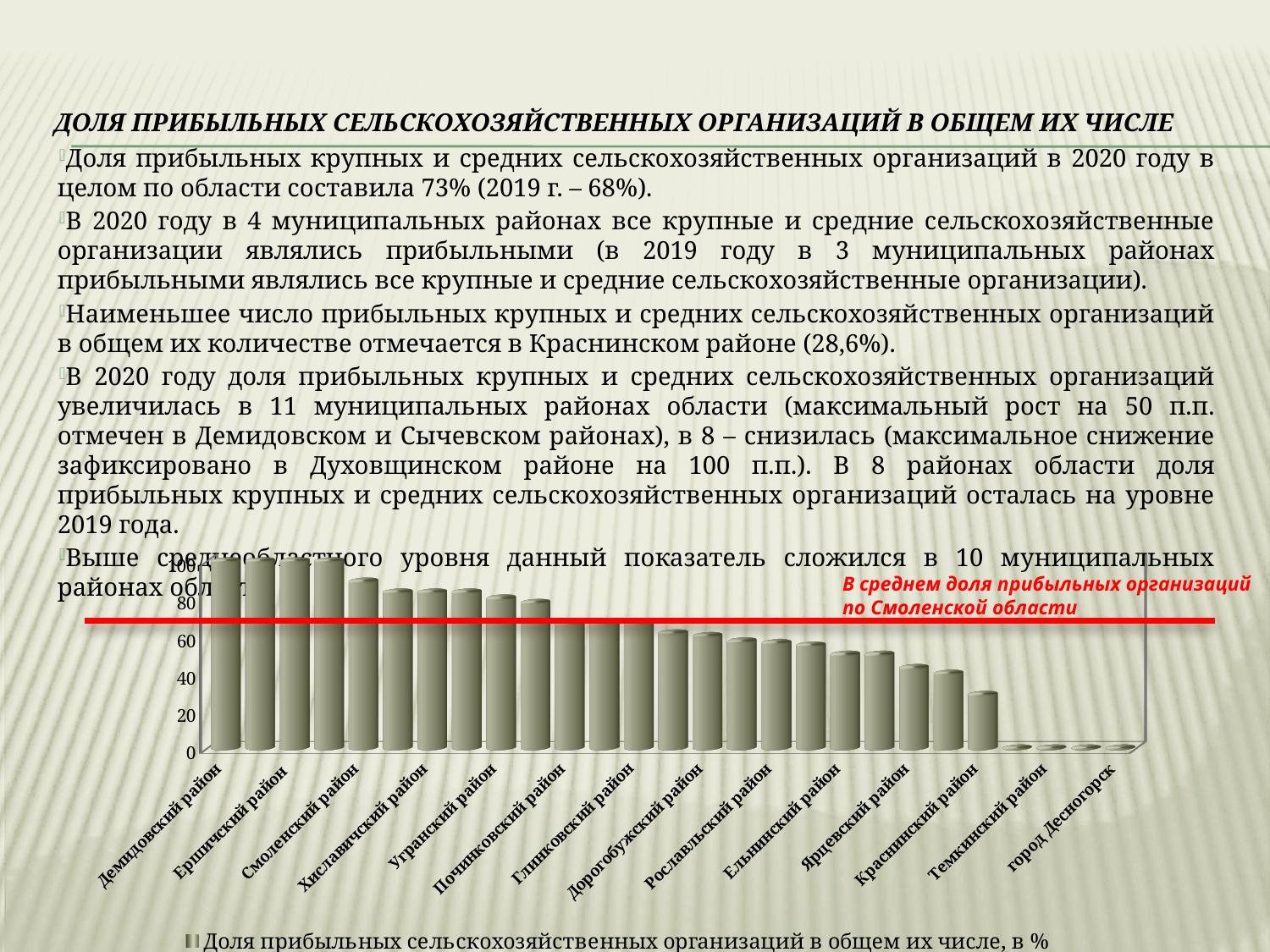
Which has the larger value, Демидовский район or Краснинский район? Демидовский район Which has the larger value, Демидовский район or город Десногорск? Демидовский район How many district labels are readable on the x axis of the chart? 14 What does the red horizontal line on the chart represent? В среднем доля прибыльных организаций по Смоленской области What is the highest tick value shown on the vertical axis? 100 Do the bar values rise or fall moving from left to right along the x axis? fall Is the value for город Десногорск greater or less than 20? less What kind of chart is shown on the slide? bar chart Is the value for Краснинский район greater or less than 60? less Is the value for Демидовский район greater or less than 80? greater What is the legend entry of the chart? Доля прибыльных сельскохозяйственных организаций в общем их числе, в % How many series does the chart legend list? 1